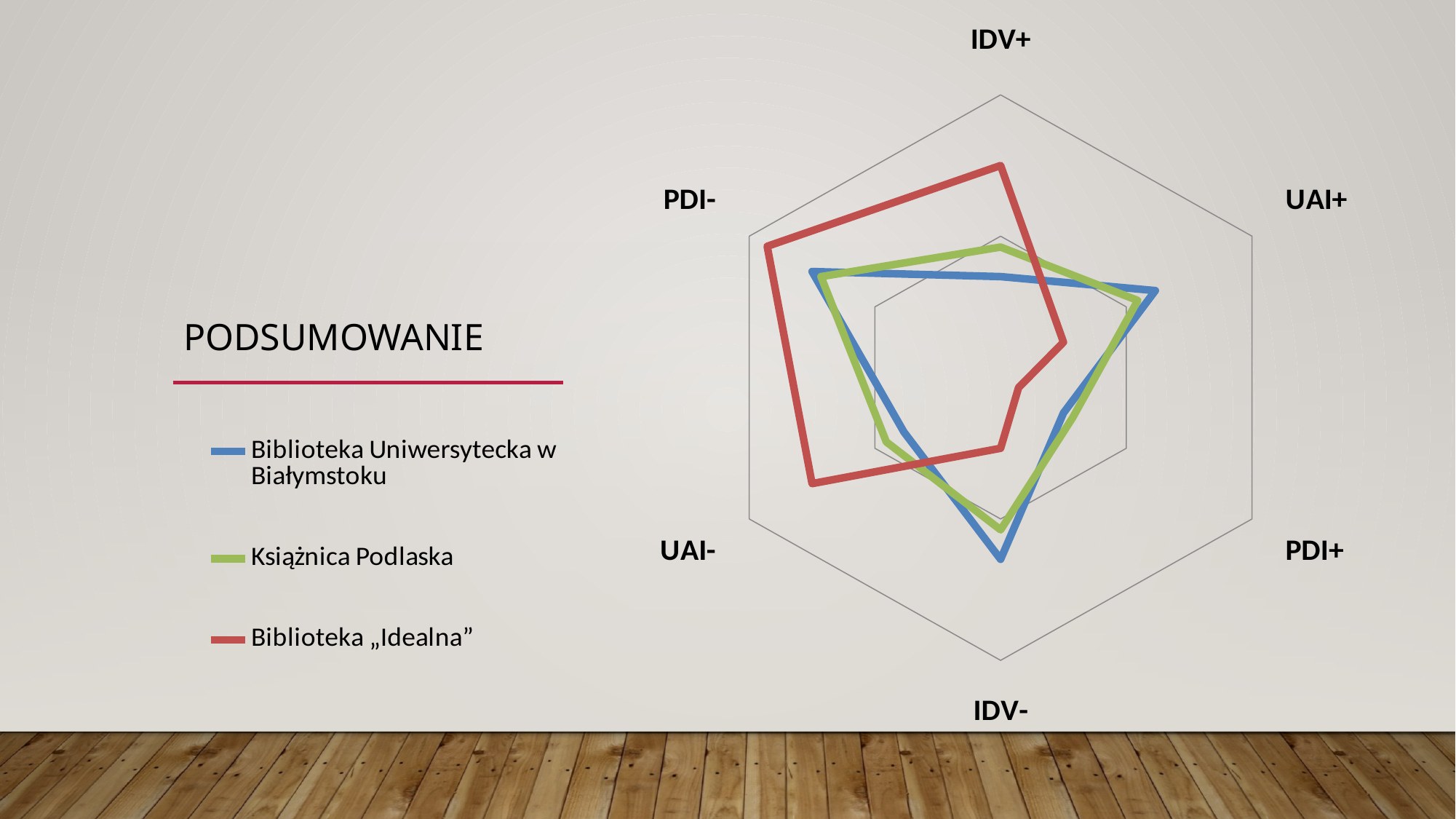
Which colour represents Książnica Podlaska in the chart? Green Which series has the lowest value on the IDV- axis? Biblioteka „Idealna” Which series has the highest value on the PDI- axis? Biblioteka „Idealna” On the UAI+ axis, which is larger: Biblioteka Uniwersytecka w Białymstoku or Biblioteka „Idealna”? Biblioteka Uniwersytecka w Białymstoku Which series has the lowest value on the IDV+ axis? Biblioteka Uniwersytecka w Białymstoku How many series does the legend list? 3 On the PDI+ axis, which is larger: Książnica Podlaska or Biblioteka „Idealna”? Książnica Podlaska What kind of chart is shown on the slide? Radar chart How many axes (categories) does the radar chart have? 6 Which series has the lowest value on the UAI+ axis? Biblioteka „Idealna” Which series has the highest value on the IDV+ axis? Biblioteka „Idealna” Which series has the highest value on the IDV- axis? Biblioteka Uniwersytecka w Białymstoku